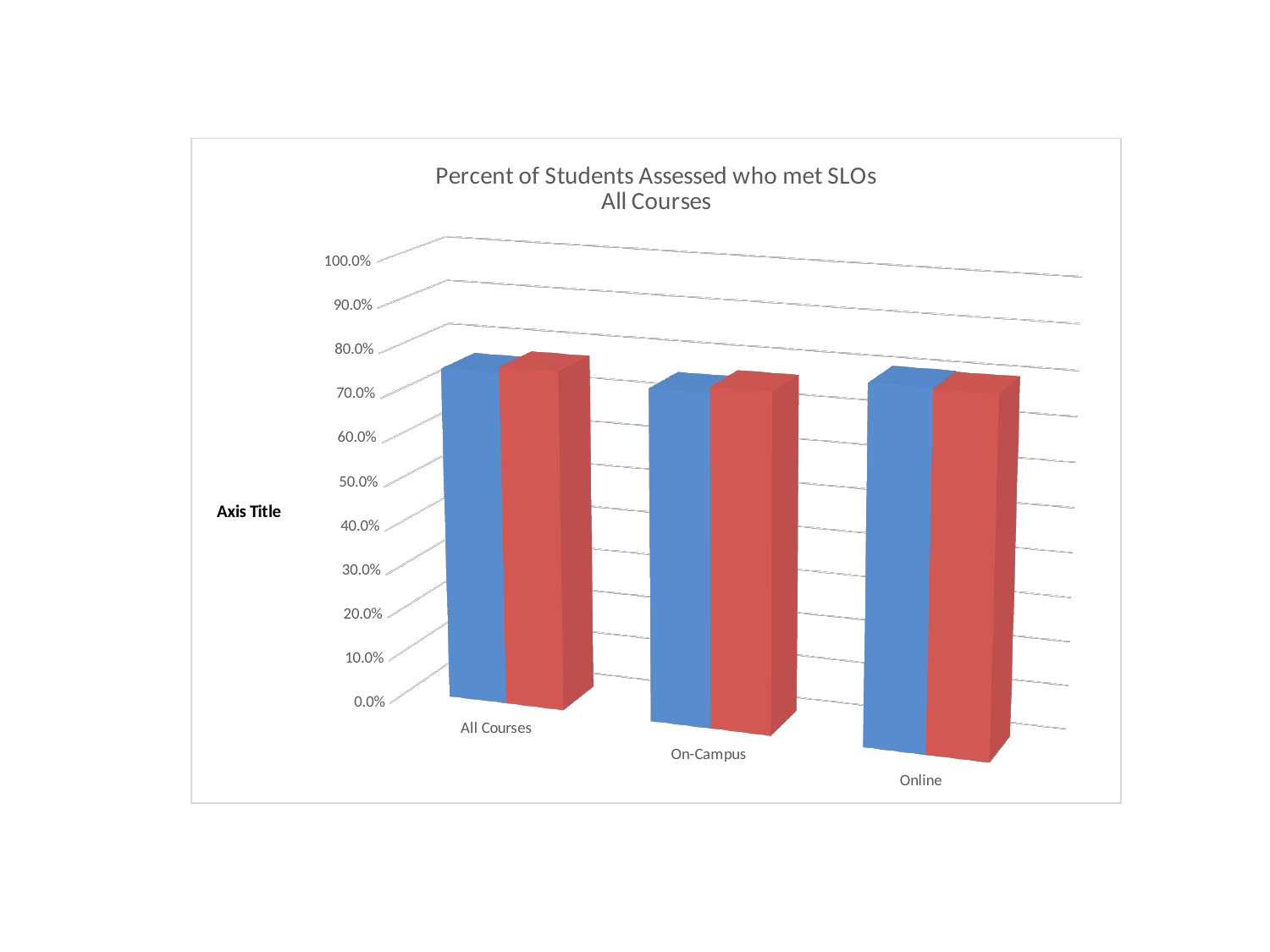
How many categories are shown on the x axis of the chart? 3 Is the value of the red bar for Online greater or less than 100.0%? less Is the value of the blue bar for On-Campus greater or less than 40.0%? greater How many bars are shown for each category in the chart? 2 Is the value of the blue bar for Online greater or less than 50.0%? greater What kind of chart is shown on the slide? bar chart What is the title of the chart? Percent of Students Assessed who met SLOs All Courses